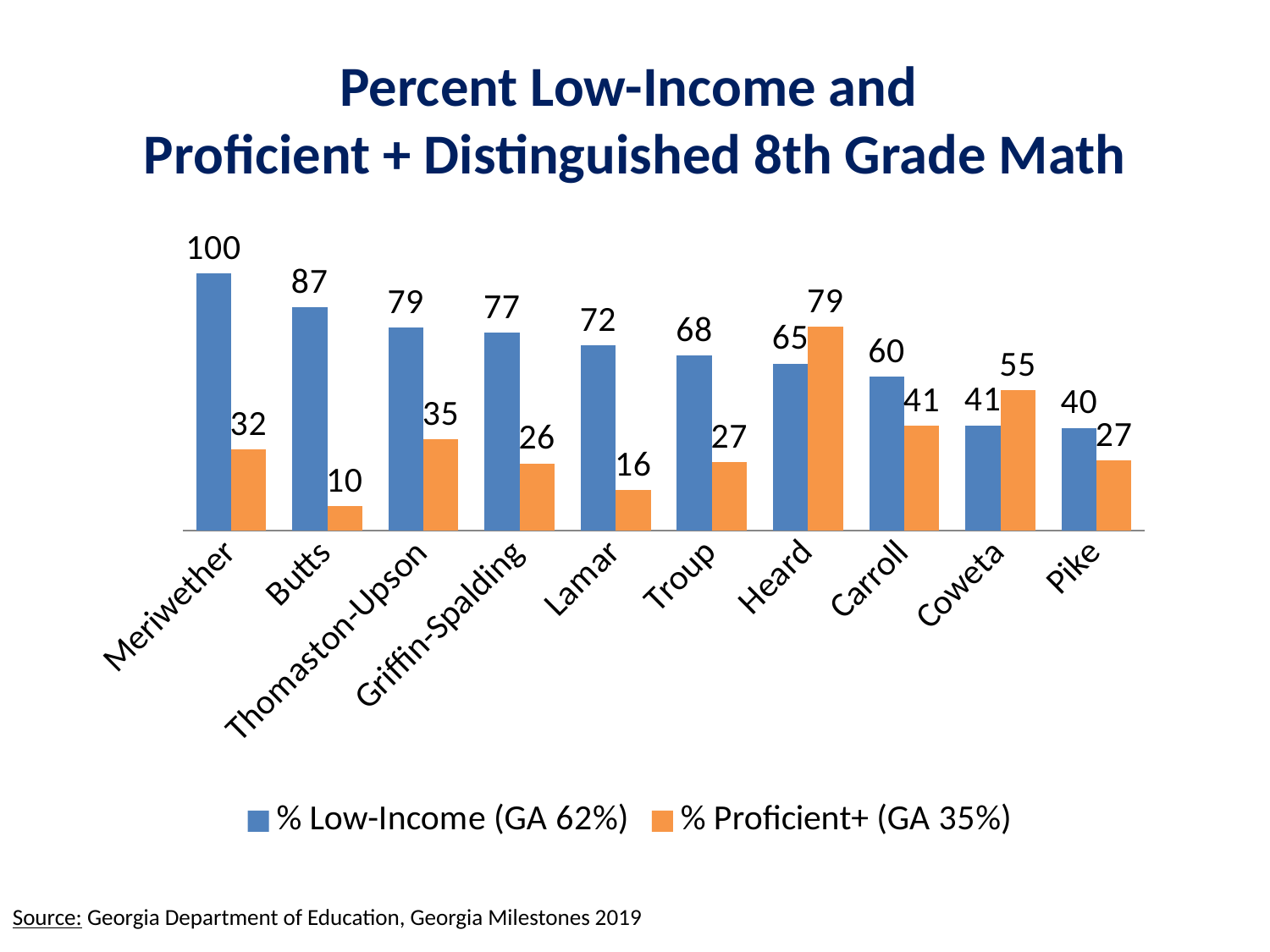
Which county has the highest % Low-Income value? Meriwether How many counties are shown on the x axis? 10 Which is larger for Coweta: % Low-Income or % Proficient+? % Proficient+ What kind of chart is shown on the slide? Bar chart Do the % Low-Income values generally rise or fall from Meriwether to Pike? Fall What is the % Proficient+ value for Butts? 10 Which county has the lowest % Proficient+ value? Butts What is the % Proficient+ value for Heard? 79 What is the difference between the % Low-Income and % Proficient+ values for Lamar? 56 What is the source cited at the bottom of the slide? Georgia Department of Education, Georgia Milestones 2019 What is the % Low-Income value for Meriwether? 100 How many series does the legend list? 2